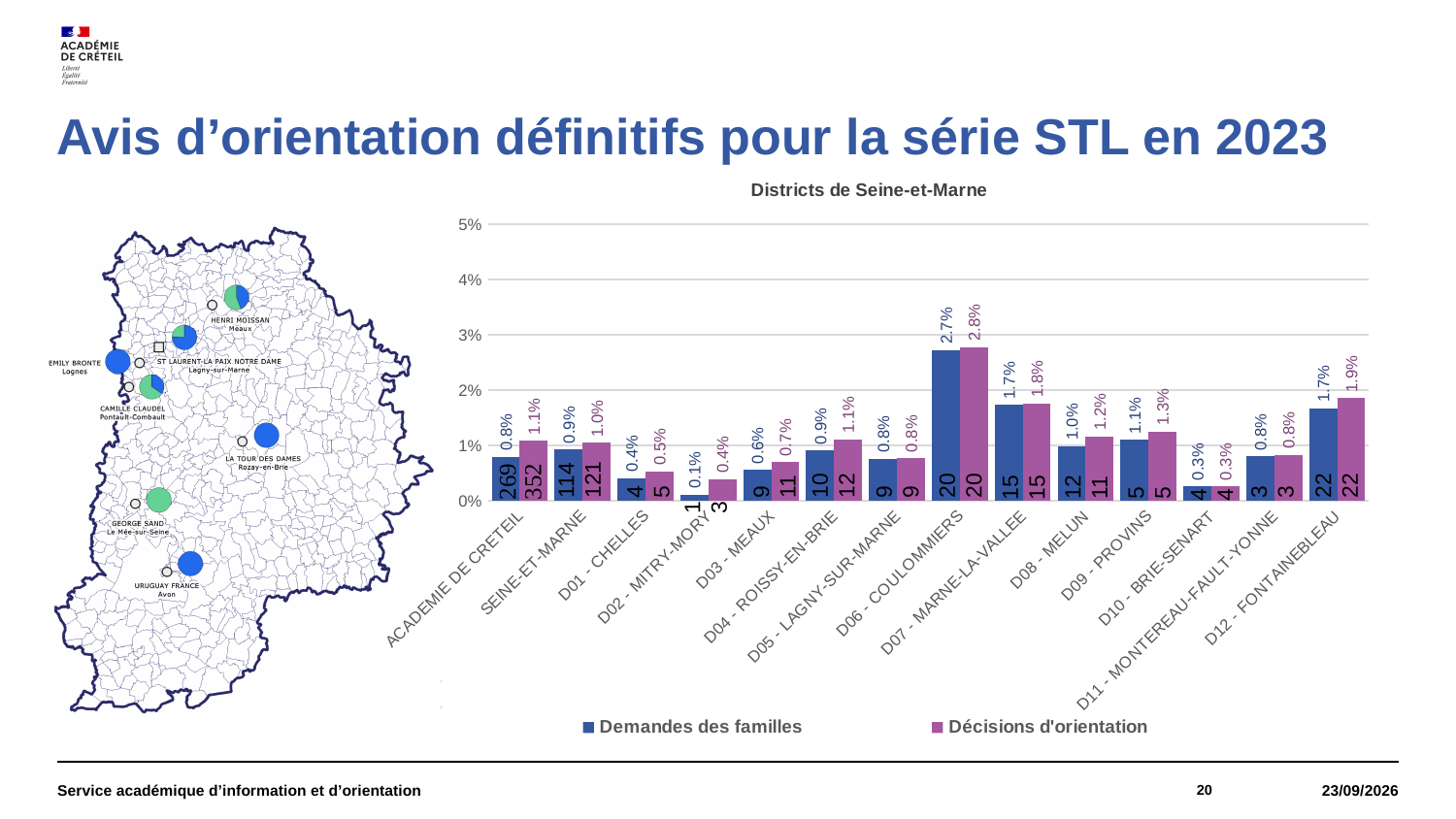
What type of chart is shown on the slide? bar chart How many categories are shown on the x axis of the chart? 14 What is the title of the chart? Districts de Seine-et-Marne How many series does the legend of the chart list? 2 Which category has the lowest 'Demandes des familles' percentage? D02 - MITRY-MORY What is the 'Demandes des familles' percentage for ACADEMIE DE CRETEIL? 0.8% Which is larger for D08 - MELUN: the 'Demandes des familles' percentage or the 'Décisions d'orientation' percentage? Décisions d'orientation What is the 'Décisions d'orientation' percentage for D06 - COULOMMIERS? 2.8% What is the difference between the 'Décisions d'orientation' and 'Demandes des familles' percentages for ACADEMIE DE CRETEIL? 0.3% What are the two series named in the chart legend? Demandes des familles; Décisions d'orientation What is the 'Décisions d'orientation' percentage for D12 - FONTAINEBLEAU? 1.9% Which category has the highest 'Demandes des familles' percentage? D06 - COULOMMIERS